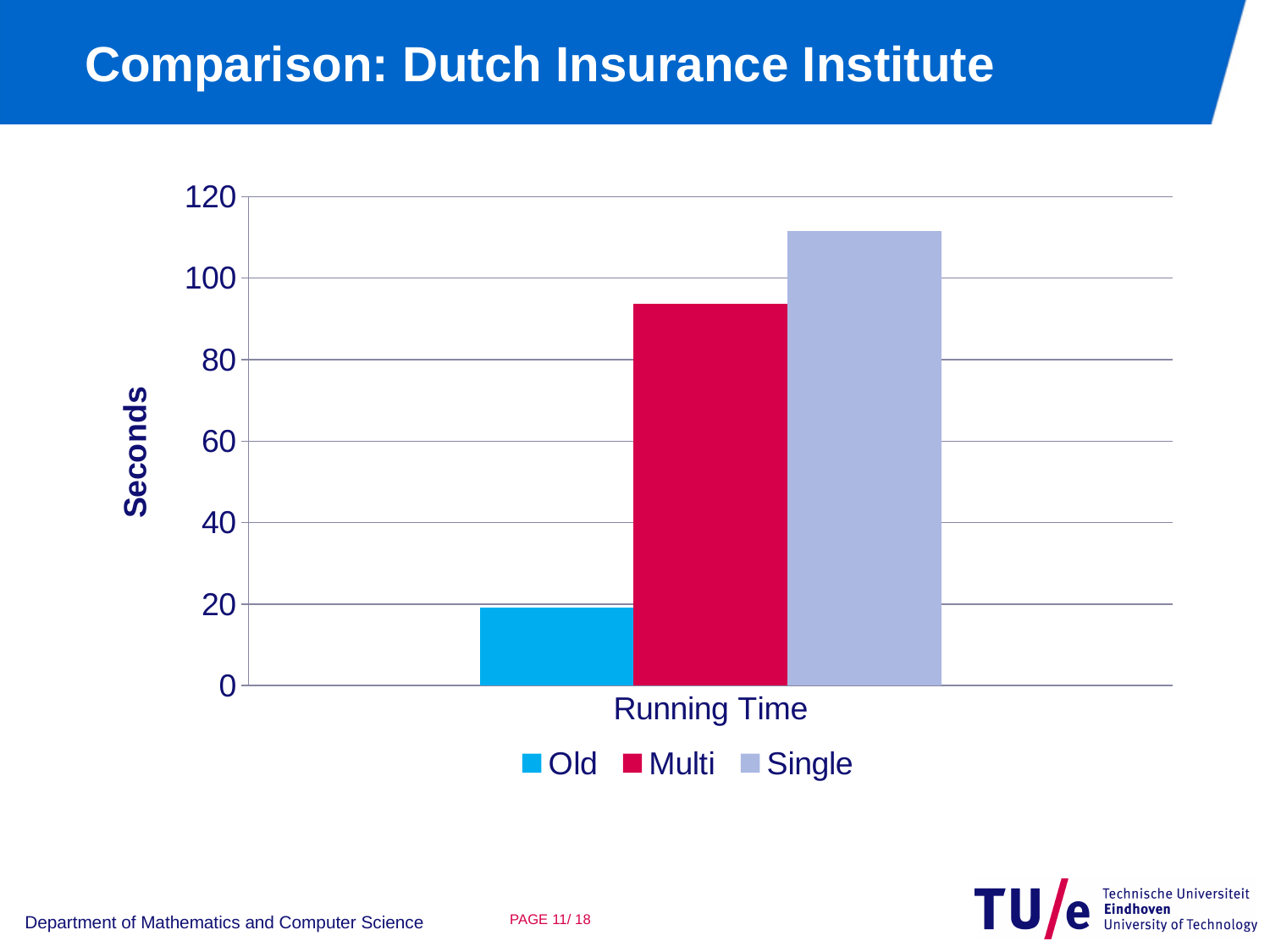
Is the running time for Single greater or less than 100 seconds? greater What kind of chart is shown on the slide? bar chart Which has a larger running time, Multi or Single? Single Is the running time for Multi greater or less than 80 seconds? greater How many series does the legend list? 3 Is the running time for Multi greater or less than 100 seconds? less Which series has the highest running time? Single Which has a larger running time, Old or Multi? Multi What is the label on the vertical axis? Seconds Which series has the lowest running time? Old What is the category label on the horizontal axis? Running Time